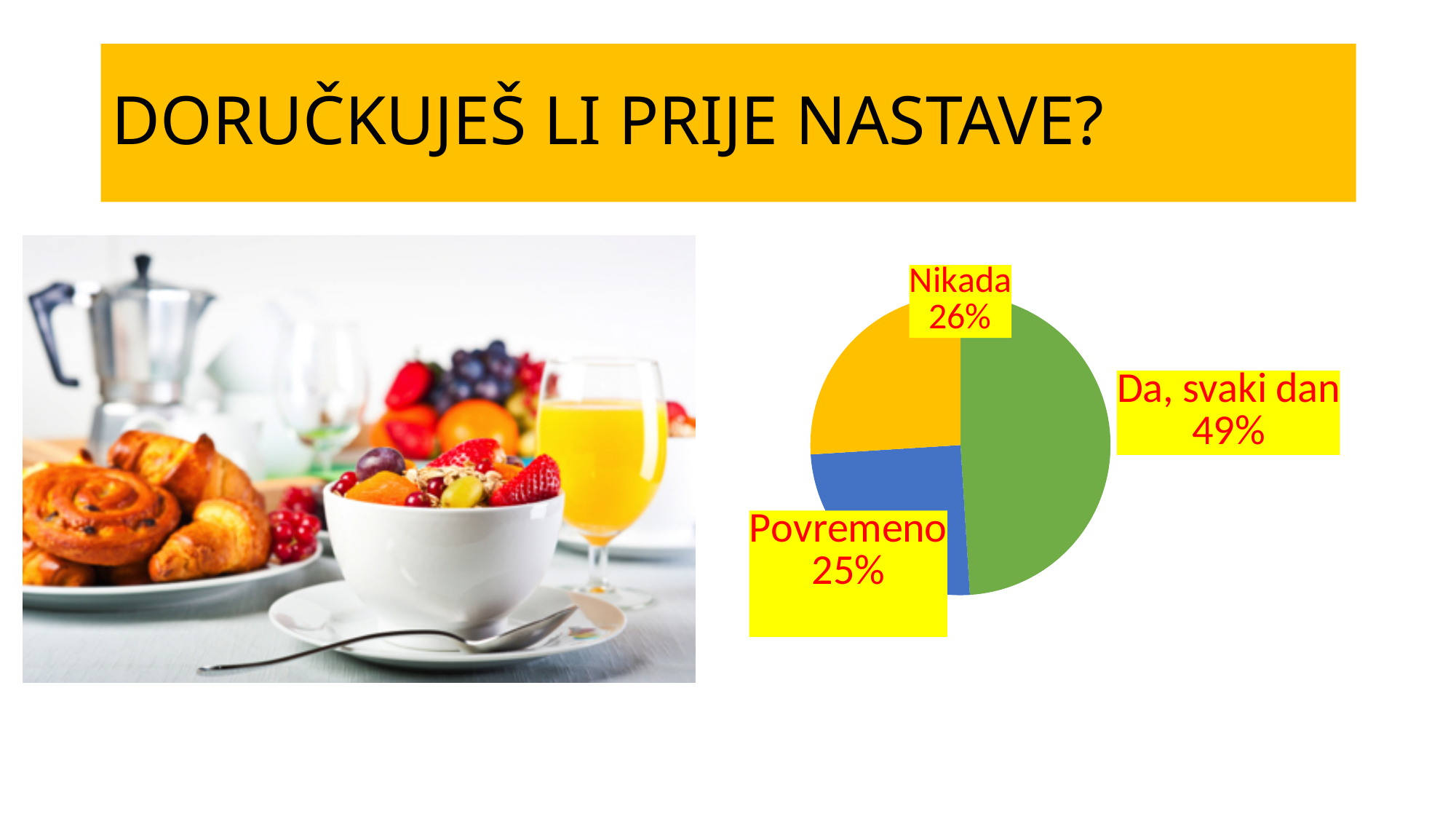
What share of the pie does "Da, svaki dan" represent? 49% Which category has the smallest slice of the pie? Povremeno What is the title of the slide containing the chart? DORUČKUJEŠ LI PRIJE NASTAVE? What share of the pie does "Povremeno" represent? 25% What is the difference in percentage points between "Nikada" and "Povremeno"? 1 What share of the pie does "Nikada" represent? 26% Which category has the largest slice of the pie? Da, svaki dan Which is larger, the slice for "Da, svaki dan" or the slice for "Povremeno"? Da, svaki dan How many slices does the pie chart have? 3 What kind of chart is shown on the slide? Pie chart What is the difference in percentage points between "Da, svaki dan" and "Nikada"? 23 What colour is the slice for "Da, svaki dan"? Green